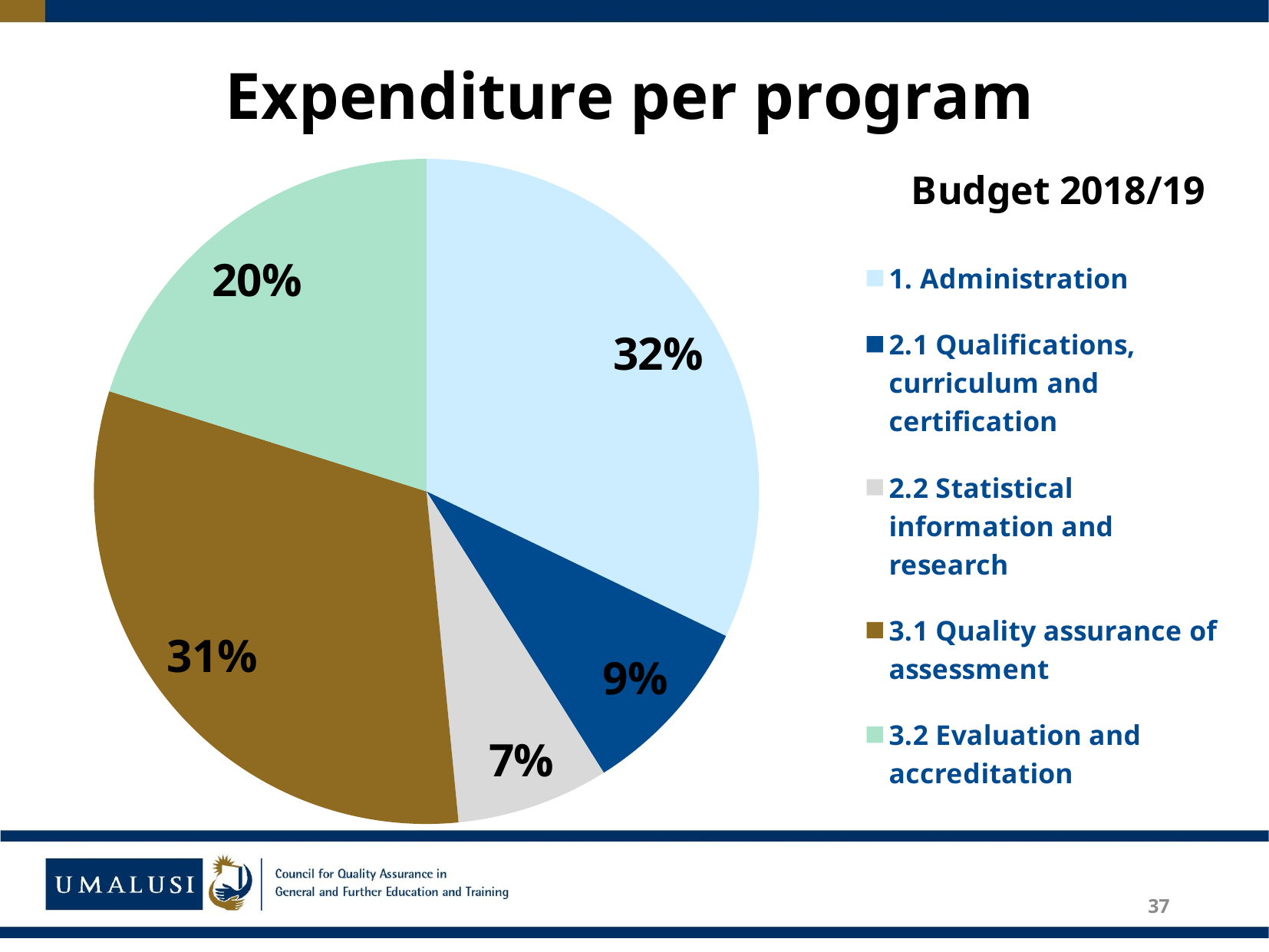
What share of the budget goes to 2.1 Qualifications, curriculum and certification? 9% Which has a larger share: 3.1 Quality assurance of assessment or 3.2 Evaluation and accreditation? 3.1 Quality assurance of assessment What share of the budget goes to 1. Administration? 32% Which program has the smallest share of the budget? 2.2 Statistical information and research What is the title shown above the legend of the pie chart? Budget 2018/19 How many programs are shown in the pie chart? 5 Which program has the largest share of the budget? 1. Administration What share of the budget goes to 2.2 Statistical information and research? 7% What kind of chart is shown on the slide? pie chart What is the difference in percentage points between 3.2 Evaluation and accreditation and 2.1 Qualifications, curriculum and certification? 11